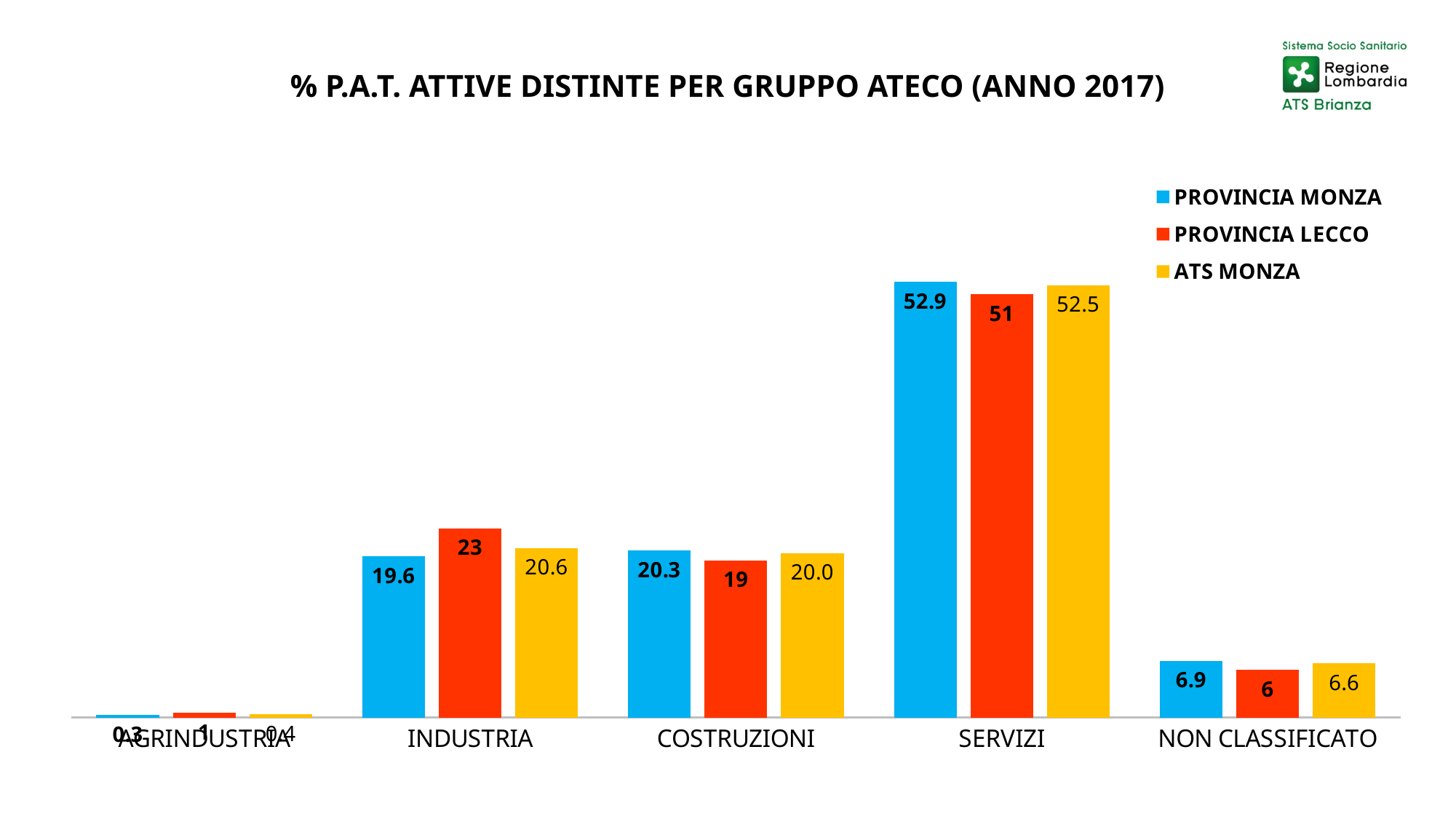
What is the title of the chart? % P.A.T. ATTIVE DISTINTE PER GRUPPO ATECO (ANNO 2017) What is the difference between the PROVINCIA LECCO and PROVINCIA MONZA values in the INDUSTRIA category? 3.4 What kind of chart is shown on the slide? bar chart Which category has the lowest value for PROVINCIA LECCO? AGRINDUSTRIA How many series does the legend list? 3 What is the value for PROVINCIA LECCO in the SERVIZI category? 51 How many categories are shown on the x axis? 5 Which category has the highest value for PROVINCIA MONZA? SERVIZI What is the value for ATS MONZA in the COSTRUZIONI category? 20.0 In the COSTRUZIONI category, which is larger: PROVINCIA MONZA or PROVINCIA LECCO? PROVINCIA MONZA What is the value for PROVINCIA MONZA in the INDUSTRIA category? 19.6 What is the value for ATS MONZA in the NON CLASSIFICATO category? 6.6